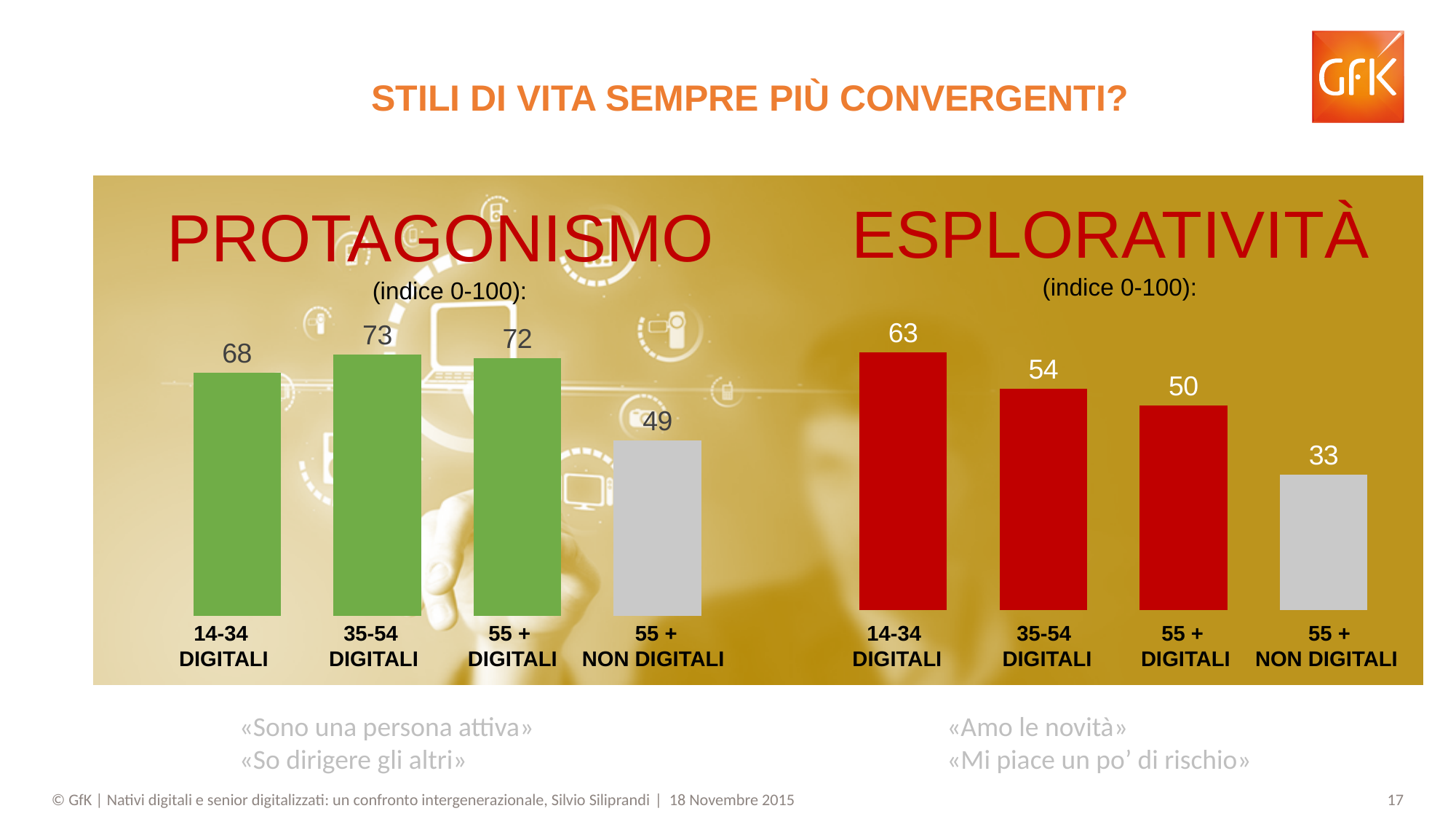
In the PROTAGONISMO chart, which category has the lowest value? 55 + NON DIGITALI In the PROTAGONISMO chart, what colour is the bar for 55 + NON DIGITALI? Grey In the ESPLORATIVITÀ chart, which category has the highest value? 14-34 DIGITALI In the PROTAGONISMO chart, what is the value for 35-54 DIGITALI? 73 What kind of chart is the PROTAGONISMO chart? Bar chart How many categories are shown in the ESPLORATIVITÀ chart? 4 In the ESPLORATIVITÀ chart, what is the difference between the values for 14-34 DIGITALI and 35-54 DIGITALI? 9 In the ESPLORATIVITÀ chart, which is larger: the value for 35-54 DIGITALI or 55 + DIGITALI? 35-54 DIGITALI In the PROTAGONISMO chart, which is larger: the value for 14-34 DIGITALI or 55 + NON DIGITALI? 14-34 DIGITALI In the ESPLORATIVITÀ chart, what is the value for 55 + NON DIGITALI? 33 In the PROTAGONISMO chart, what is the difference between the values for 55 + DIGITALI and 55 + NON DIGITALI? 23 In the ESPLORATIVITÀ chart, do the values rise or fall from left to right across the categories? Fall